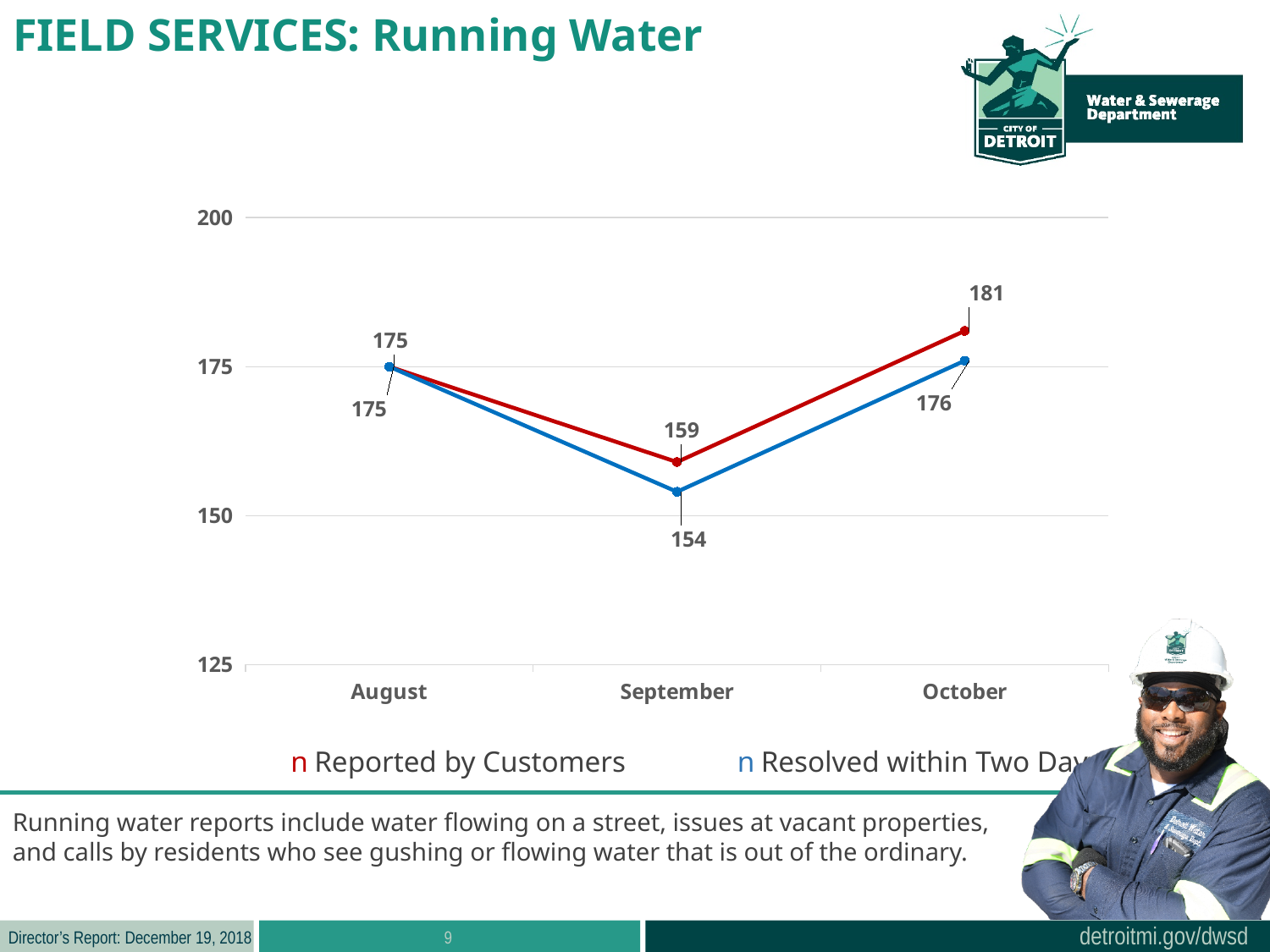
What type of chart is shown on the slide? line chart In which month is the Resolved within Two Days value highest? October What is the value for Reported by Customers in October? 181 Which is larger in September: Reported by Customers or Resolved within Two Days? Reported by Customers What colour is the line for Reported by Customers? red How many series does the legend list? 2 What is the value for Resolved within Two Days in September? 154 What is the difference between Reported by Customers and Resolved within Two Days in October? 5 In which month is the Reported by Customers value lowest? September How many months are plotted on the x axis? 3 Does the Reported by Customers series rise or fall from September to October? rise What is the value for Reported by Customers in August? 175